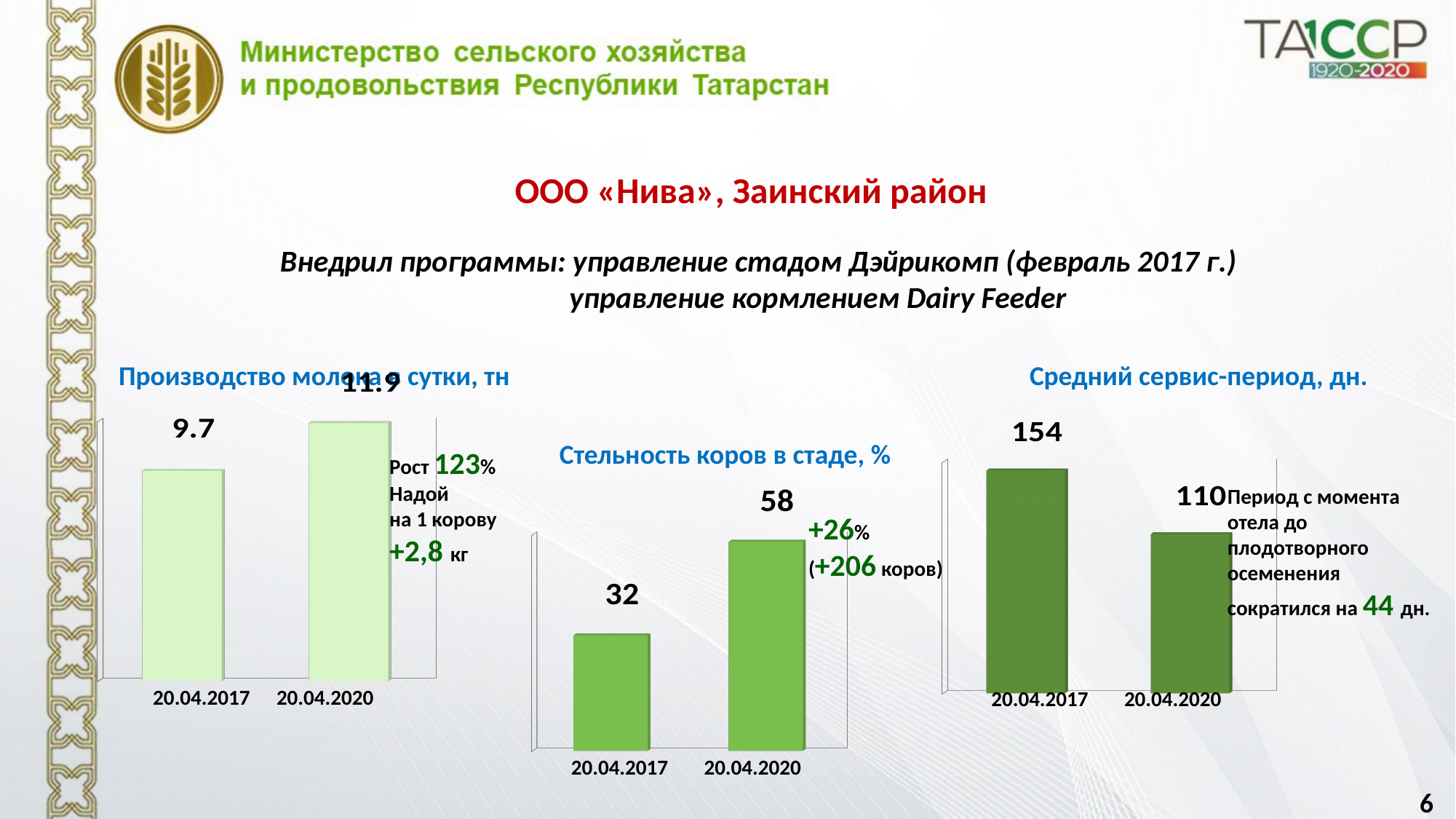
In the chart 'Средний сервис-период, дн.', what is the difference between the 20.04.2017 and 20.04.2020 values? 44 In the chart 'Средний сервис-период, дн.', what is the value for 20.04.2017? 154 In the chart 'Средний сервис-период, дн.', what is the value for 20.04.2020? 110 In the chart 'Стельность коров в стаде, %', which date has the highest value? 20.04.2020 In the chart 'Производство молока в сутки, тн', do the values rise or fall from 20.04.2017 to 20.04.2020? rise In the chart 'Производство молока в сутки, тн', what is the value for 20.04.2020? 11.9 In the chart 'Стельность коров в стаде, %', what is the value for 20.04.2017? 32 In the chart 'Стельность коров в стаде, %', what is the value for 20.04.2020? 58 In the chart 'Стельность коров в стаде, %', what is the difference between the 20.04.2020 and 20.04.2017 values? 26 What kind of chart is 'Средний сервис-период, дн.'? bar chart In the chart 'Средний сервис-период, дн.', which date has the lowest value? 20.04.2020 In the chart 'Производство молока в сутки, тн', what is the value for 20.04.2017? 9.7